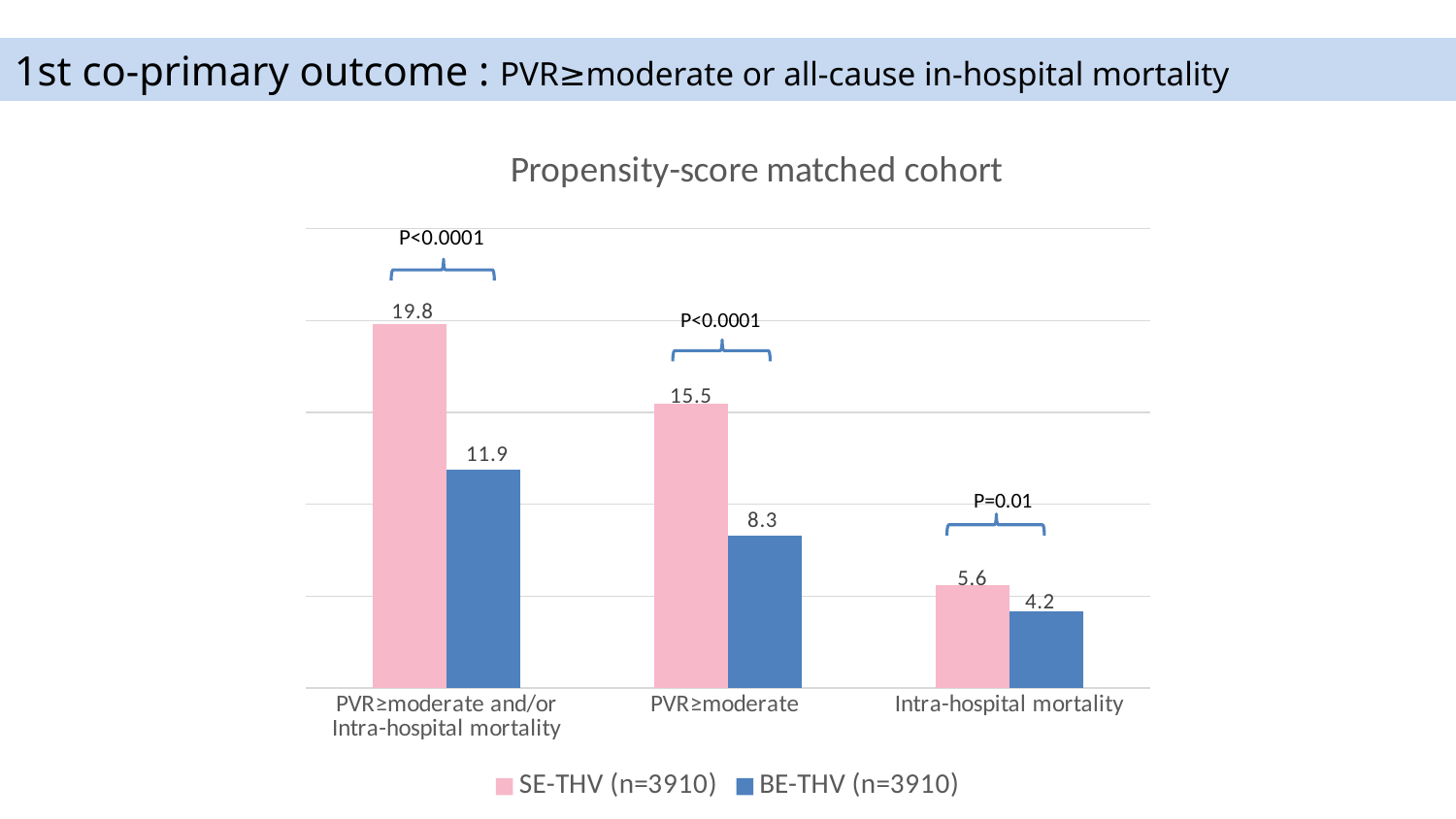
Which is larger in the 'Intra-hospital mortality' category: SE-THV (n=3910) or BE-THV (n=3910)? SE-THV (n=3910) What is the value for SE-THV (n=3910) in the 'PVR≥moderate and/or Intra-hospital mortality' category? 19.8 What is the value for BE-THV (n=3910) in the 'Intra-hospital mortality' category? 4.2 What P value is shown above the 'Intra-hospital mortality' bars? P=0.01 What kind of chart is shown on the slide? Bar chart How many series does the legend list? 2 Which category has the highest value for SE-THV (n=3910)? PVR≥moderate and/or Intra-hospital mortality How many categories are shown on the x axis? 3 Which category has the lowest value for BE-THV (n=3910)? Intra-hospital mortality What is the difference between the SE-THV (n=3910) and BE-THV (n=3910) values in the 'PVR≥moderate' category? 7.2 What is the title of the chart? Propensity-score matched cohort What is the value for BE-THV (n=3910) in the 'PVR≥moderate' category? 8.3